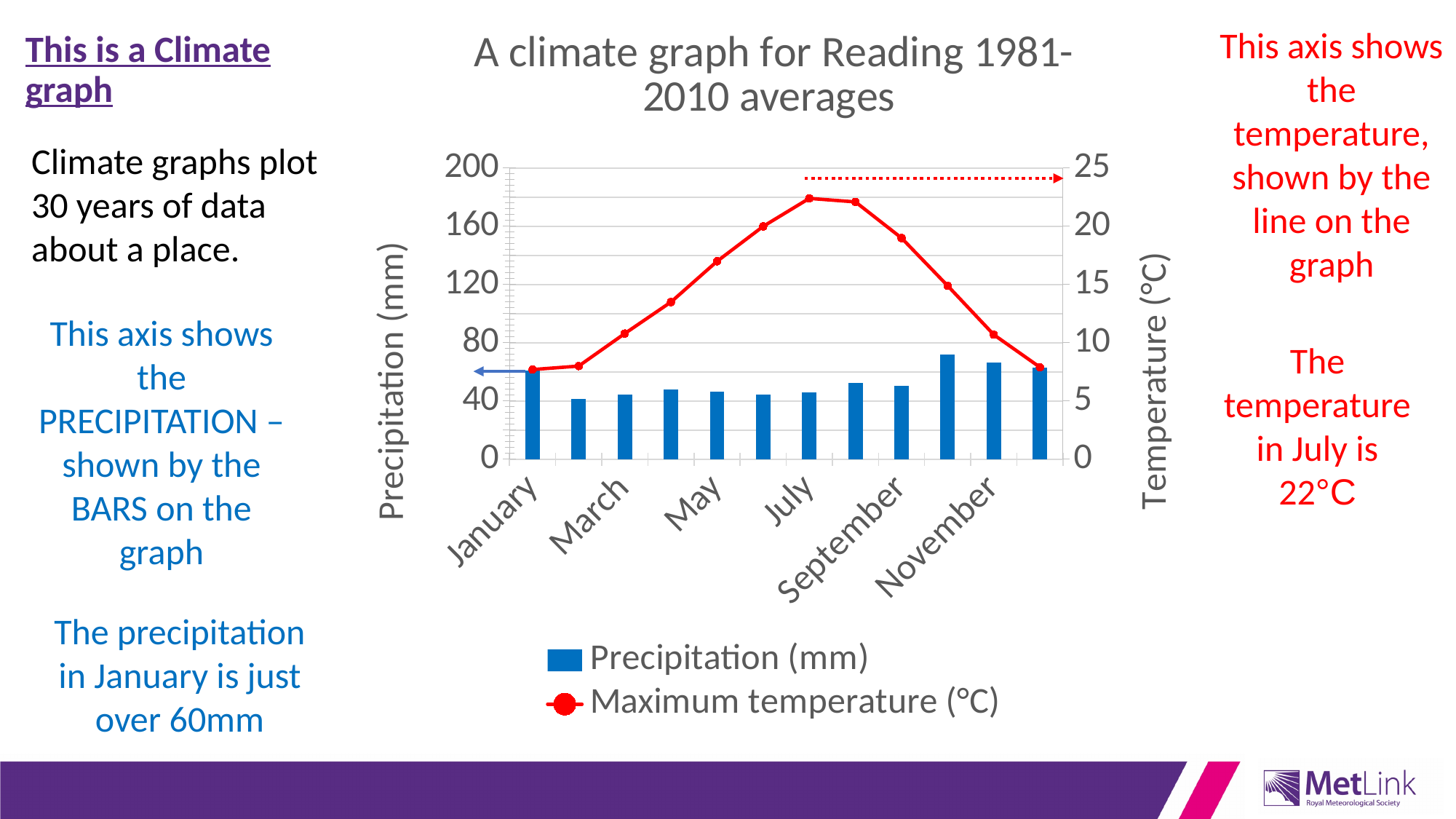
What is the maximum temperature in July, as stated on the slide? 22°C Is the maximum temperature for January greater or less than 10°C? less What kind of chart is this? A combined bar and line chart Which month has the highest maximum temperature? July Is the precipitation for March greater or less than 60 mm? less What is the title of the chart? A climate graph for Reading 1981-2010 averages How many months (bars) are plotted on the chart? 12 How many series does the legend list? 2 Which month has the highest precipitation bar? October Which has the larger precipitation, November or March? November Is the precipitation for November greater or less than 60 mm? greater Does the maximum temperature rise or fall from January to July? Rises